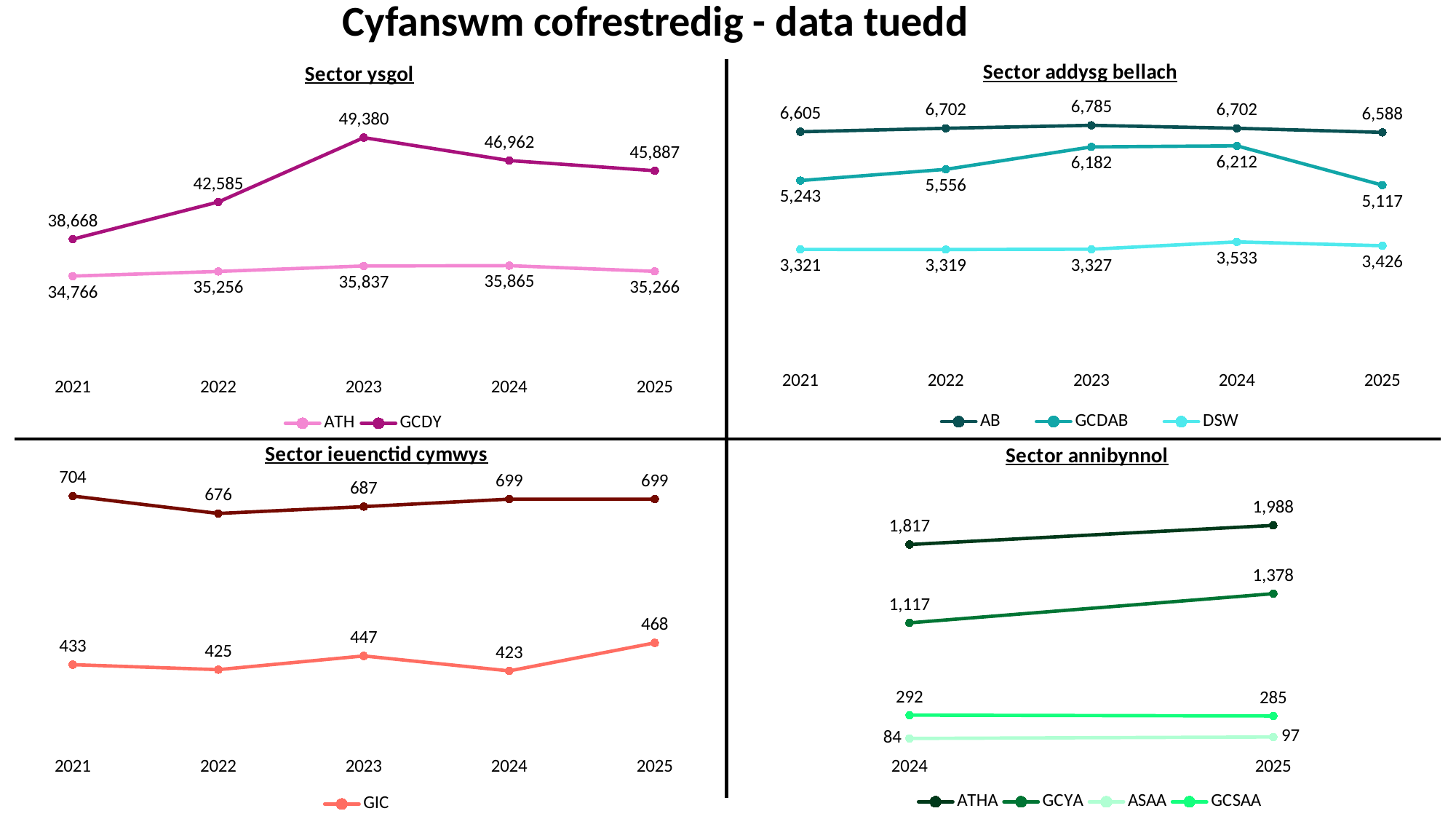
In the Sector annibynnol chart, does the GCSAA series rise or fall from 2024 to 2025? fall In the Sector ieuenctid cymwys chart, how many years are shown on the x axis? 5 In the Sector ieuenctid cymwys chart, what is the GIC value for 2025? 468 In the Sector addysg bellach chart, which is larger: AB in 2023 or GCDAB in 2023? AB in 2023 In the Sector addysg bellach chart, what is the GCDAB value for 2025? 5,117 In the Sector addysg bellach chart, in which year is the DSW series lowest? 2022 In the Sector ysgol chart, in which year is the ATH series highest? 2024 What kind of chart is the Sector annibynnol chart? line chart In the Sector ysgol chart, what is the GCDY value for 2023? 49,380 In the Sector ysgol chart, what is the difference between GCDY and ATH in 2021? 3,902 In the Sector annibynnol chart, what is the ATHA value for 2025? 1,988 How many series does the legend of the Sector addysg bellach chart list? 3